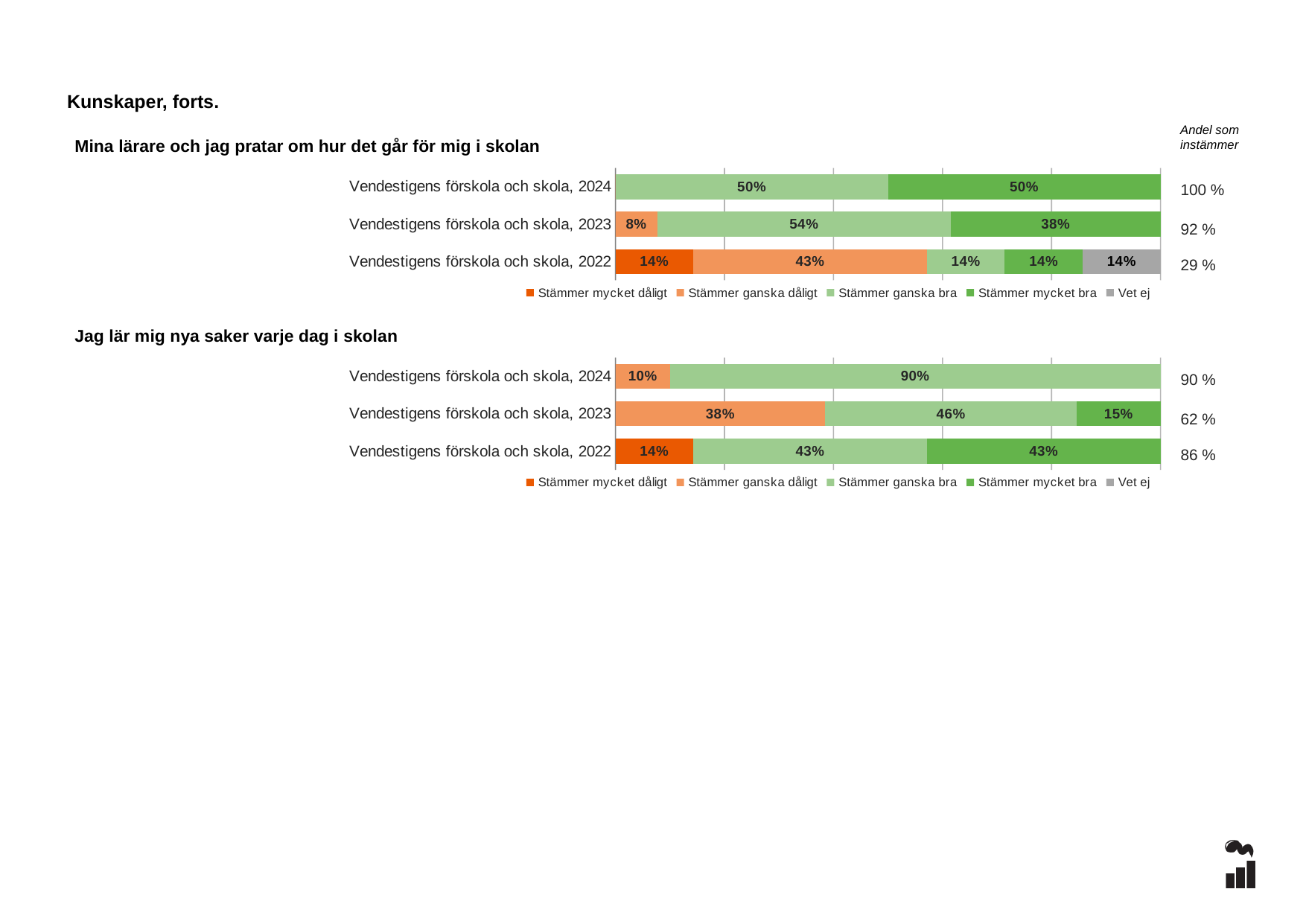
In the chart 'Mina lärare och jag pratar om hur det går för mig i skolan', what is the value for 'Stämmer ganska bra' for Vendestigens förskola och skola, 2023? 54% In the chart 'Mina lärare och jag pratar om hur det går för mig i skolan', what is the value for 'Stämmer ganska dåligt' for Vendestigens förskola och skola, 2022? 43% In the chart 'Jag lär mig nya saker varje dag i skolan', which year has the highest 'Andel som instämmer' value? 2024 In the chart 'Mina lärare och jag pratar om hur det går för mig i skolan', how many series does the legend list? 5 In the chart 'Mina lärare och jag pratar om hur det går för mig i skolan', what is the value for 'Stämmer mycket bra' for Vendestigens förskola och skola, 2024? 50% In the chart 'Jag lär mig nya saker varje dag i skolan', what is the 'Andel som instämmer' value shown for Vendestigens förskola och skola, 2023? 62 % In the chart 'Jag lär mig nya saker varje dag i skolan', what is the value for 'Stämmer ganska dåligt' for Vendestigens förskola och skola, 2023? 38% In the chart 'Jag lär mig nya saker varje dag i skolan', what is the value for 'Stämmer ganska bra' for Vendestigens förskola och skola, 2024? 90% In the chart 'Jag lär mig nya saker varje dag i skolan', what is the difference between the 'Stämmer ganska bra' values for 2024 and 2023? 44% What type of chart is used for 'Mina lärare och jag pratar om hur det går för mig i skolan'? Stacked bar chart In the chart 'Jag lär mig nya saker varje dag i skolan', how many bars (categories) are shown? 3 In the chart 'Mina lärare och jag pratar om hur det går för mig i skolan', what is the 'Andel som instämmer' value shown for Vendestigens förskola och skola, 2022? 29 %